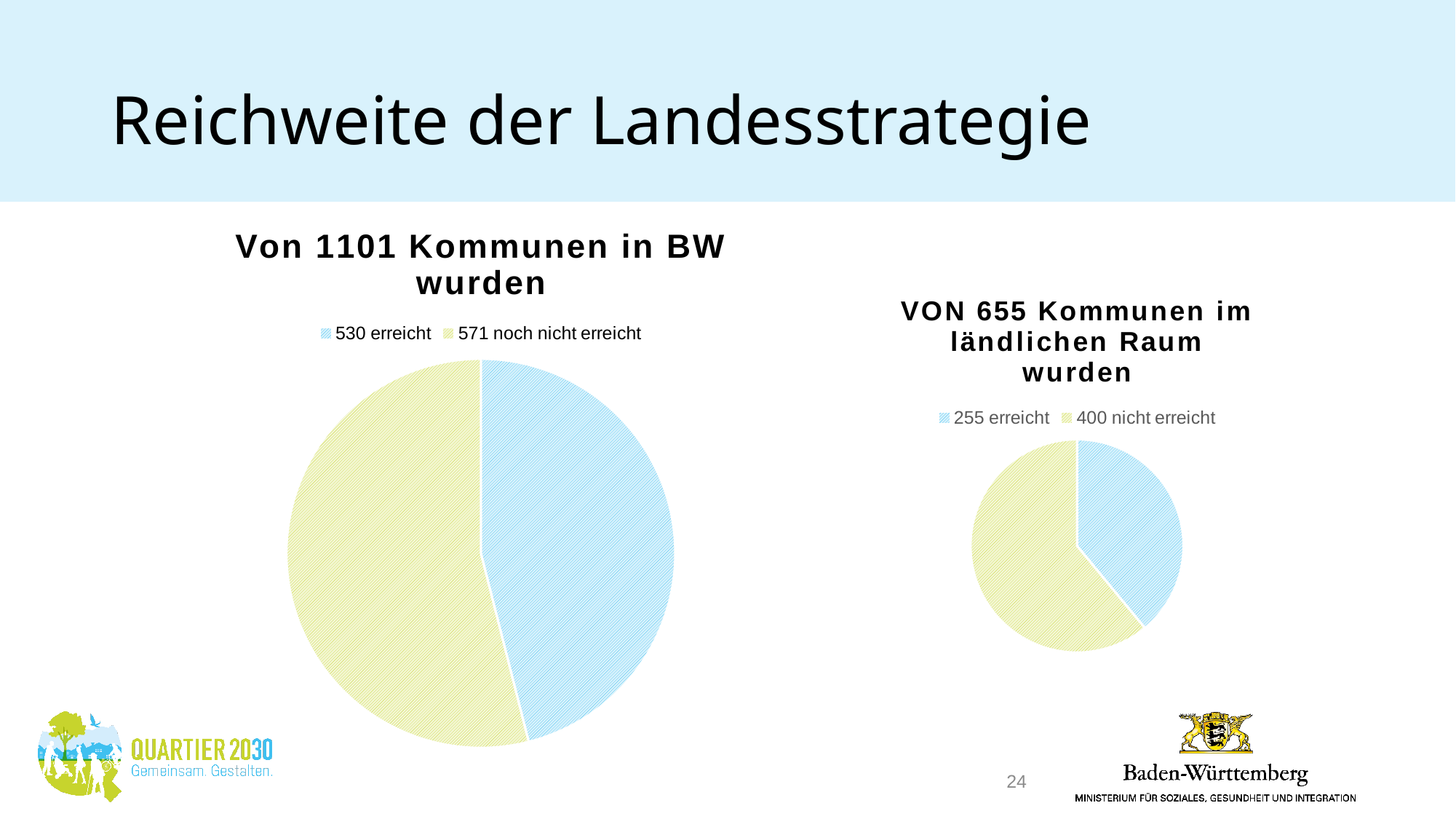
In the left pie chart ('Von 1101 Kommunen in BW wurden'), which slice is larger: 'erreicht' or 'noch nicht erreicht'? noch nicht erreicht In the left pie chart ('Von 1101 Kommunen in BW wurden'), how many Kommunen were 'erreicht'? 530 In the right pie chart ('VON 655 Kommunen im ländlichen Raum wurden'), what is the difference between the 'nicht erreicht' and 'erreicht' values? 145 What type of chart is used on the left of the slide, titled 'Von 1101 Kommunen in BW wurden'? Pie chart In the right pie chart ('VON 655 Kommunen im ländlichen Raum wurden'), how many Kommunen were 'erreicht'? 255 How many entries does the legend of the right pie chart ('VON 655 Kommunen im ländlichen Raum wurden') list? 2 In the left pie chart ('Von 1101 Kommunen in BW wurden'), which colour represents the 'erreicht' slice? Blue In the right pie chart ('VON 655 Kommunen im ländlichen Raum wurden'), how many Kommunen were 'nicht erreicht'? 400 How many slices does the left pie chart ('Von 1101 Kommunen in BW wurden') have? 2 In the right pie chart ('VON 655 Kommunen im ländlichen Raum wurden'), which slice is the largest? 400 nicht erreicht In the left pie chart ('Von 1101 Kommunen in BW wurden'), how many Kommunen were 'noch nicht erreicht'? 571 In the left pie chart ('Von 1101 Kommunen in BW wurden'), what is the difference between the 'noch nicht erreicht' and 'erreicht' values? 41